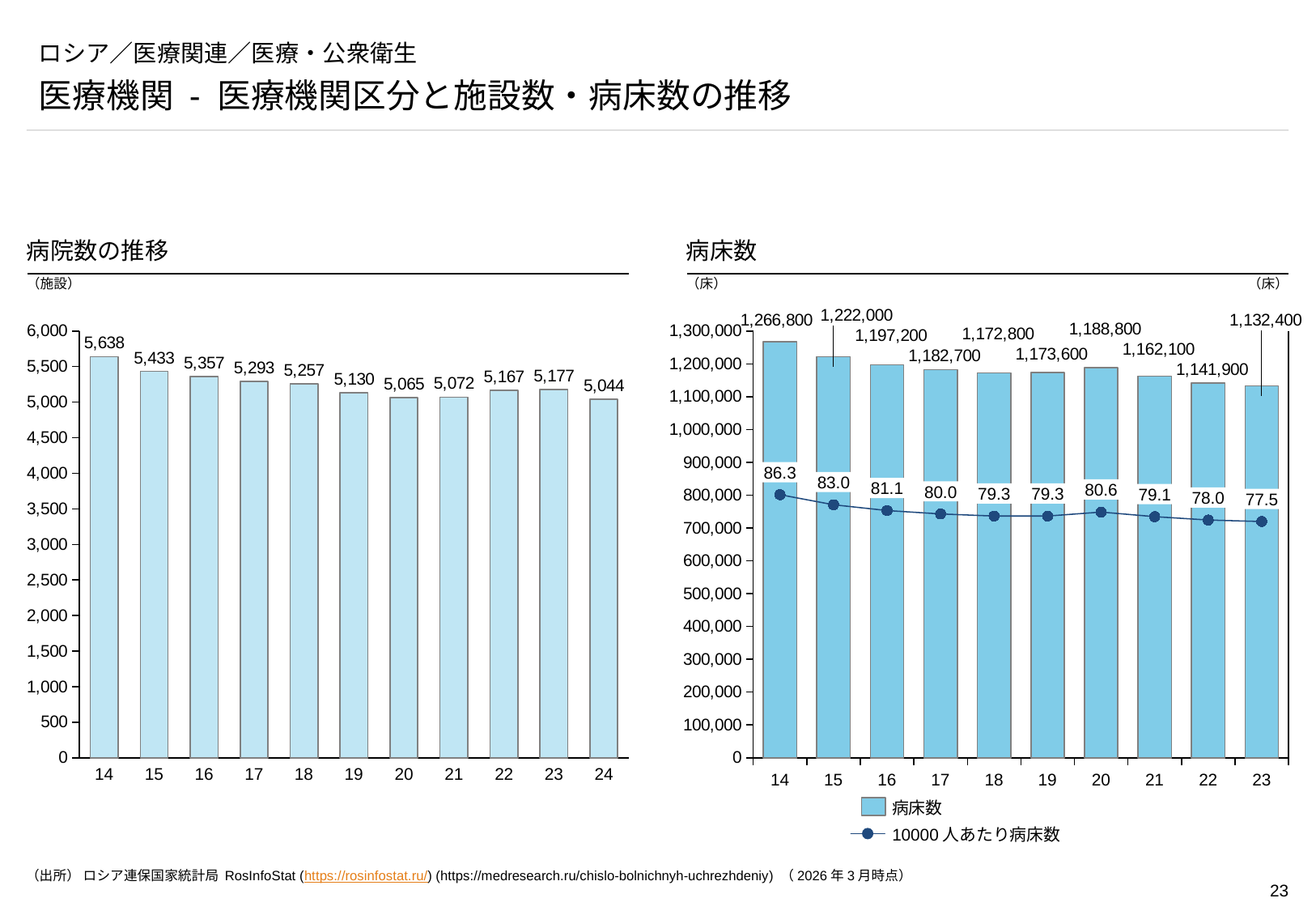
In the 病床数 chart, does the 10000人あたり病床数 line generally rise or fall from 14 to 23? fall In the 病床数 chart, what is the 病床数 value for 20? 1,188,800 What kind of chart is the 病院数の推移 chart? bar chart In the 病院数の推移 chart, which year has the lowest value? 24 In the 病院数の推移 chart, what is the difference between the values for 14 and 24? 594 In the 病床数 chart, how many series does the legend list? 2 In the 病院数の推移 chart, what is the value for 14? 5,638 In the 病床数 chart, what is the difference in 病床数 between 14 and 15? 44,800 In the 病床数 chart, what is the 10000人あたり病床数 value for 23? 77.5 In the 病院数の推移 chart, how many years are plotted? 11 In the 病床数 chart, which year has the highest 病床数? 14 In the 病院数の推移 chart, which is larger, the value for 22 or the value for 23? 23